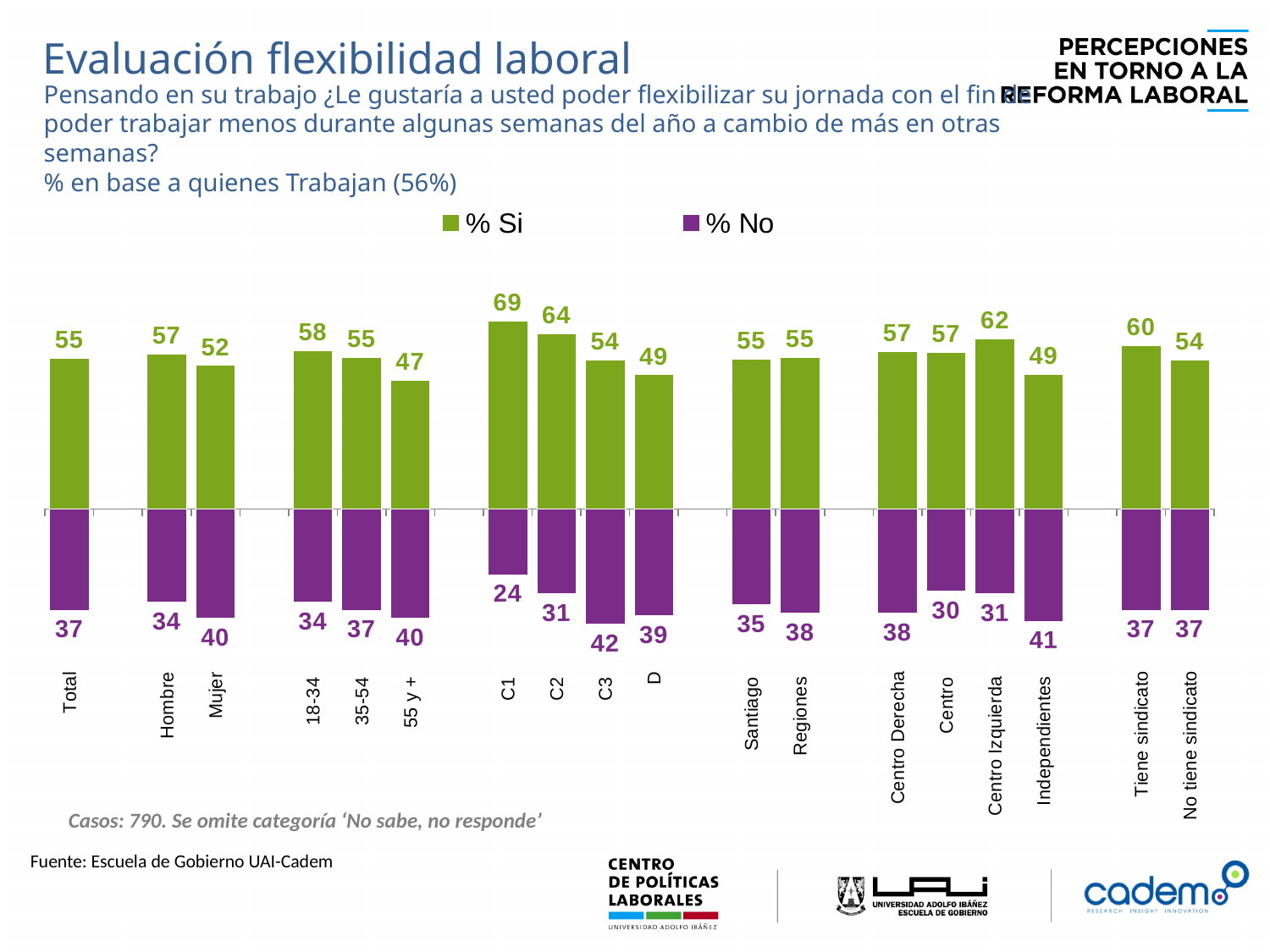
How many categories are shown on the x axis? 18 What is the % No value for Mujer? 40 What is the % Si value for Centro Izquierda? 62 Which category has the highest % No value? C3 Which category has the lowest % No value? C1 Which is larger, the % Si value for Tiene sindicato or for No tiene sindicato? Tiene sindicato What is the difference between the % Si values for Hombre and Mujer? 5 What kind of chart is shown on the slide? Bar chart Which category has the lowest % Si value? 55 y + Which category has the highest % Si value? C1 What is the % Si value for C1? 69 How many series does the legend list? 2